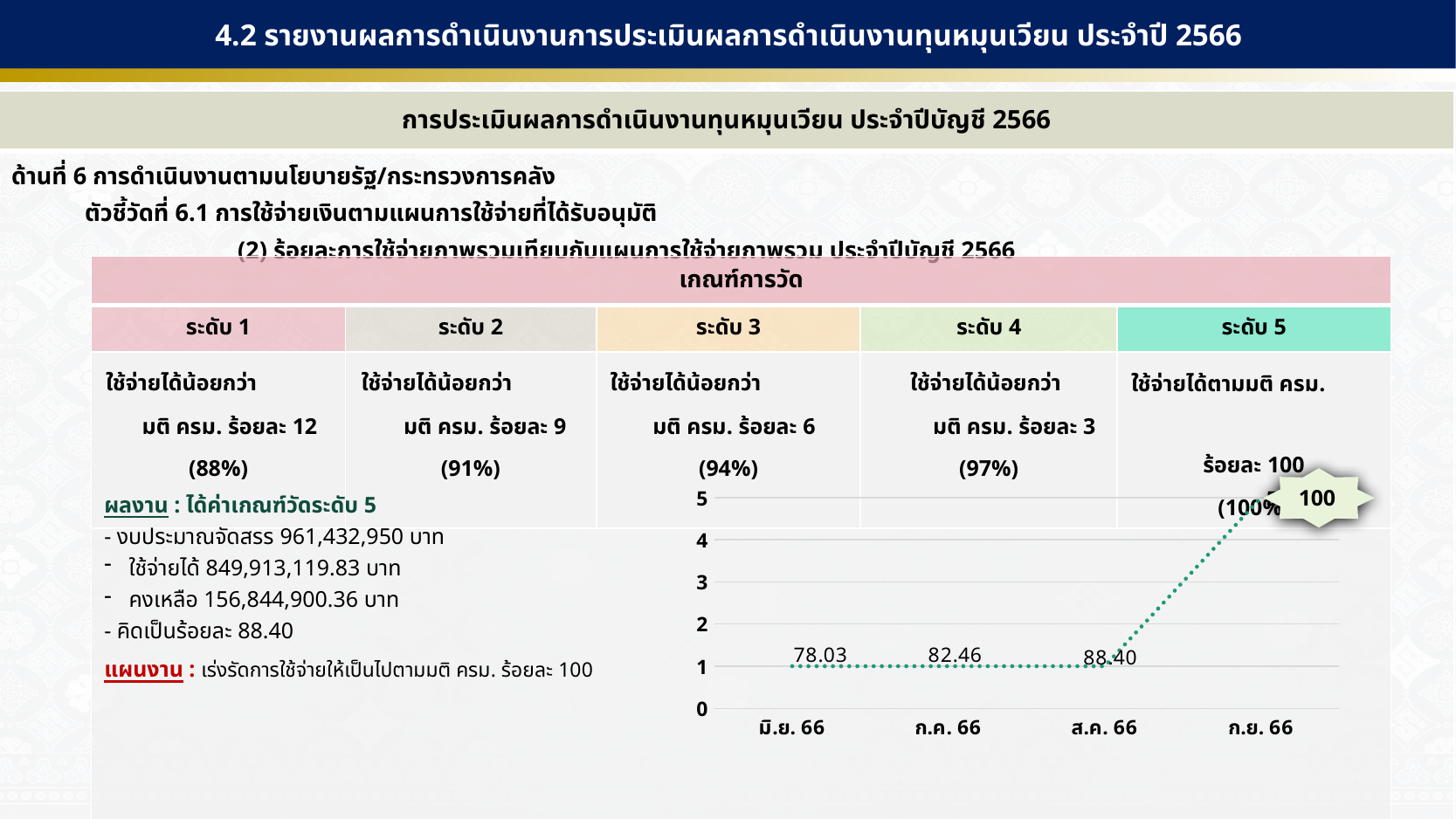
What is the difference between the labelled values for ก.ค. 66 and มิ.ย. 66? 4.43 Which is larger, the labelled value for ส.ค. 66 or for ก.ค. 66? ส.ค. 66 Do the labelled values rise or fall from มิ.ย. 66 to ก.ย. 66? Rise What value is labelled for ก.ย. 66 on the line chart? 100 What value is labelled for ส.ค. 66 on the line chart? 88.40 What value is labelled for ก.ค. 66 on the line chart? 82.46 What value is labelled for มิ.ย. 66 on the line chart? 78.03 Which month has the lowest labelled value on the line chart? มิ.ย. 66 What is the difference between the labelled values for ก.ย. 66 and ส.ค. 66? 11.60 How many months are plotted on the x axis of the line chart? 4 Which month has the highest labelled value on the line chart? ก.ย. 66 What kind of chart is shown on the slide? Line chart